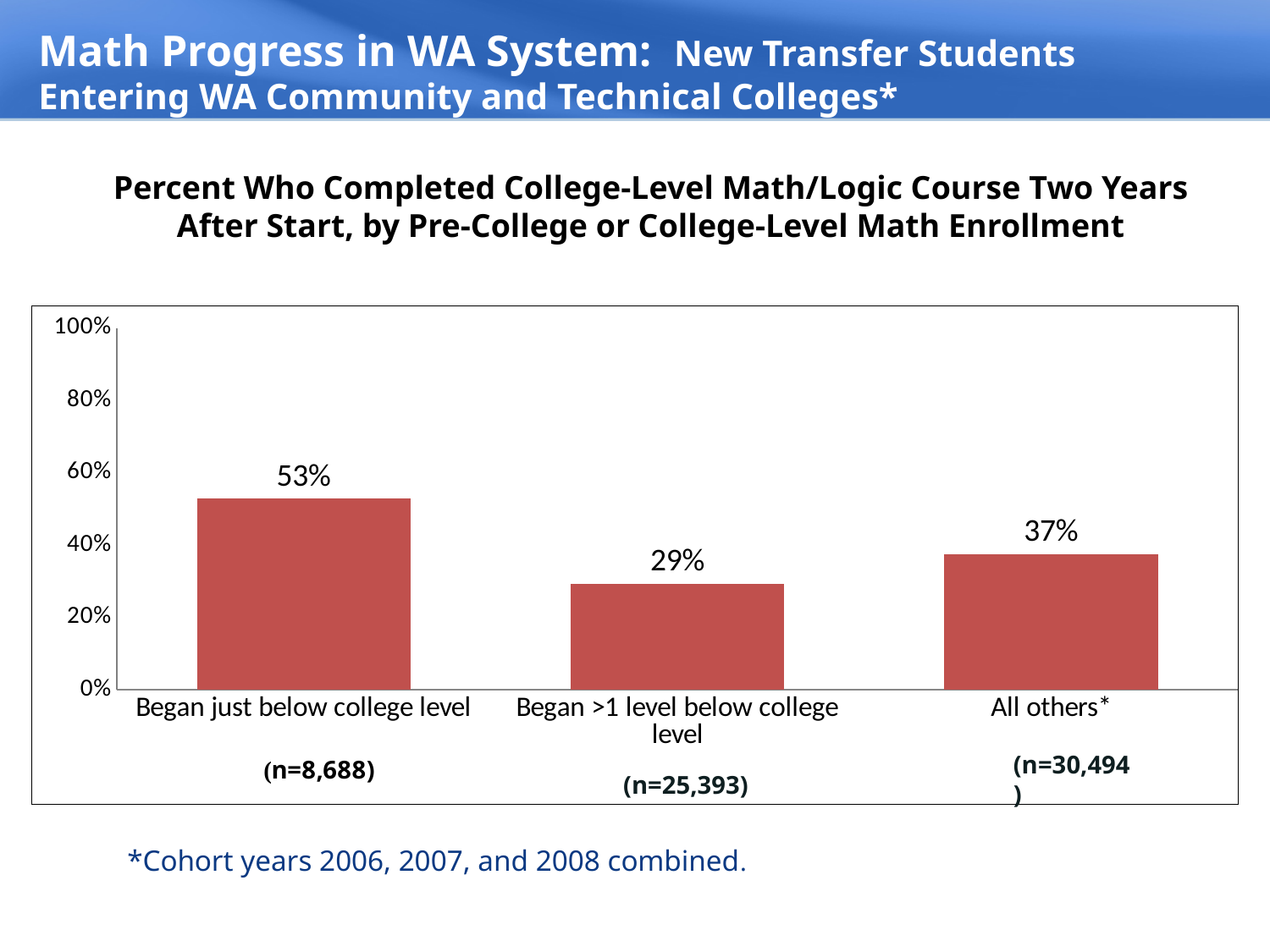
What is the value for "Began >1 level below college level"? 29% Which category has the highest value? Began just below college level Which is larger, the value for "All others*" or the value for "Began >1 level below college level"? All others* Is the value for "Began just below college level" greater or less than 40%? greater What is the difference between the values for "All others*" and "Began >1 level below college level"? 8% What is the difference between the values for "Began just below college level" and "Began >1 level below college level"? 24% What is the value for "All others*"? 37% Which category has the lowest value? Began >1 level below college level What is the value for "Began just below college level"? 53% How many categories are shown in the chart? 3 What is the sample size (n) shown for the "Began >1 level below college level" category? n=25,393 What kind of chart is shown on the slide? Bar chart